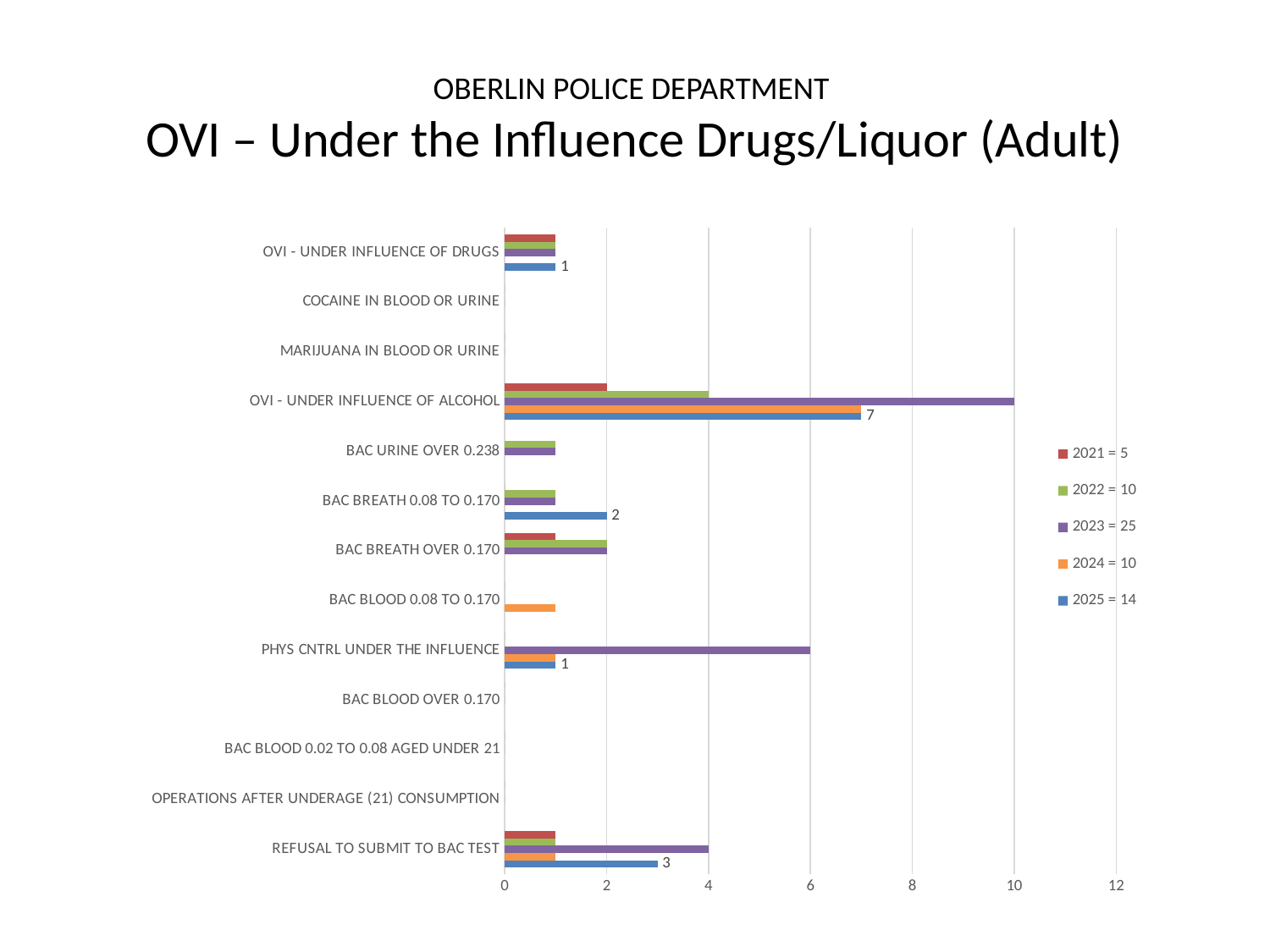
What is the 2023 value for PHYS CNTRL UNDER THE INFLUENCE? 6 For 2025, which is larger: OVI - UNDER INFLUENCE OF ALCOHOL or REFUSAL TO SUBMIT TO BAC TEST? OVI - UNDER INFLUENCE OF ALCOHOL How many categories are listed on the vertical axis of the chart? 13 What is the 2025 value for REFUSAL TO SUBMIT TO BAC TEST? 3 What is the 2025 value for OVI - UNDER INFLUENCE OF ALCOHOL? 7 What is the difference between the 2025 values for OVI - UNDER INFLUENCE OF ALCOHOL and REFUSAL TO SUBMIT TO BAC TEST? 4 Which category has the longest bar in the chart? OVI - UNDER INFLUENCE OF ALCOHOL What is the 2023 value for OVI - UNDER INFLUENCE OF ALCOHOL? 10 What is the 2025 value for BAC BREATH 0.08 TO 0.170? 2 What kind of chart is shown on the slide? bar chart How many series does the legend list? 5 Is the 2024 value for OVI - UNDER INFLUENCE OF ALCOHOL greater or less than 6? greater